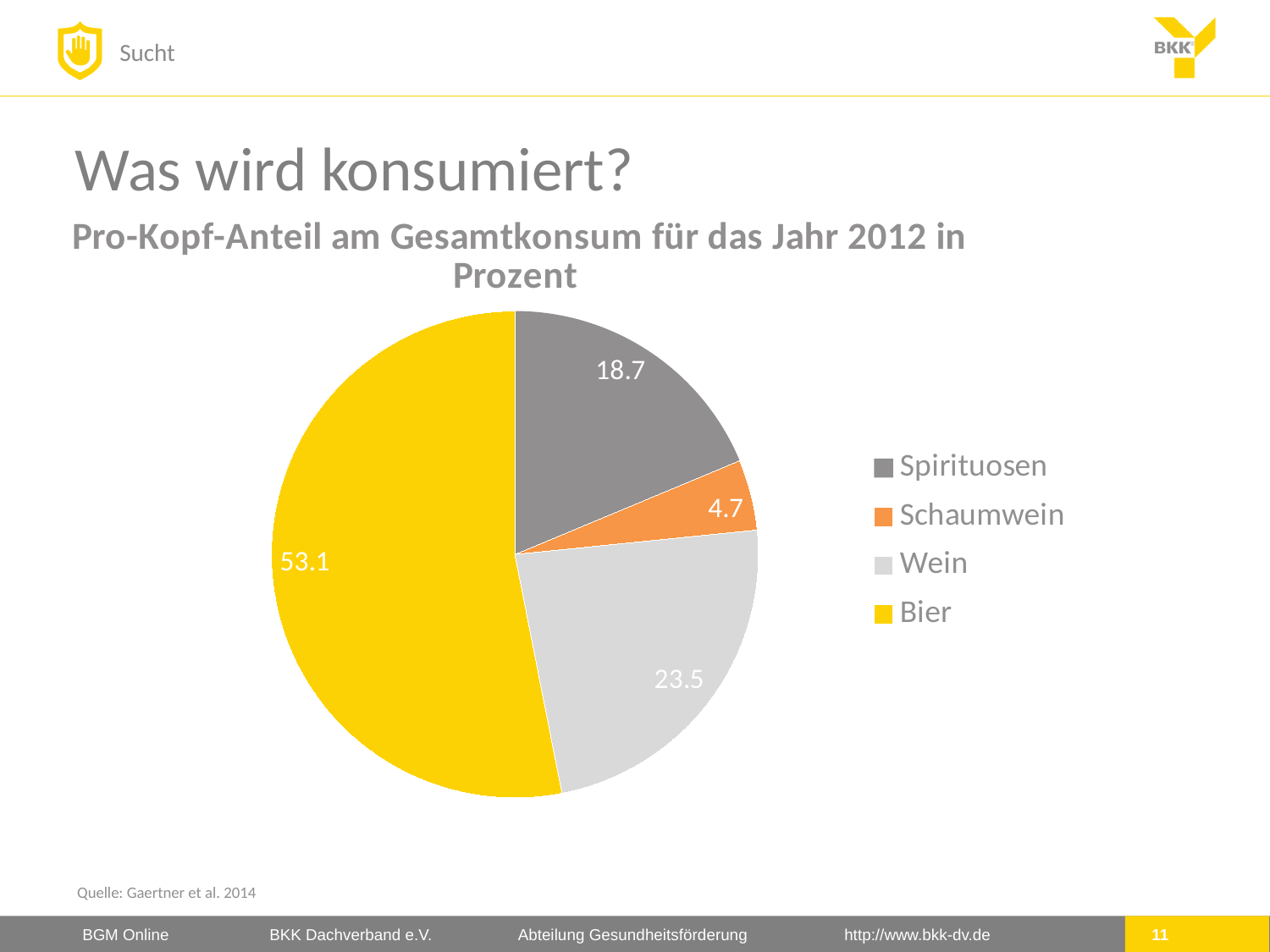
What is the value for Schaumwein? 4.7 What is the value for Spirituosen? 18.7 Which colour represents Schaumwein in the legend? orange What type of chart is shown on the slide? pie chart Which is larger, the value for Wein or the value for Spirituosen? Wein What is the value for Wein? 23.5 How many categories does the pie chart show? 4 What is the difference between the values for Bier and Wein? 29.6 What is the value for Bier? 53.1 What is the title of the chart? Pro-Kopf-Anteil am Gesamtkonsum für das Jahr 2012 in Prozent Which category has the largest share of the pie? Bier Which category has the smallest share of the pie? Schaumwein